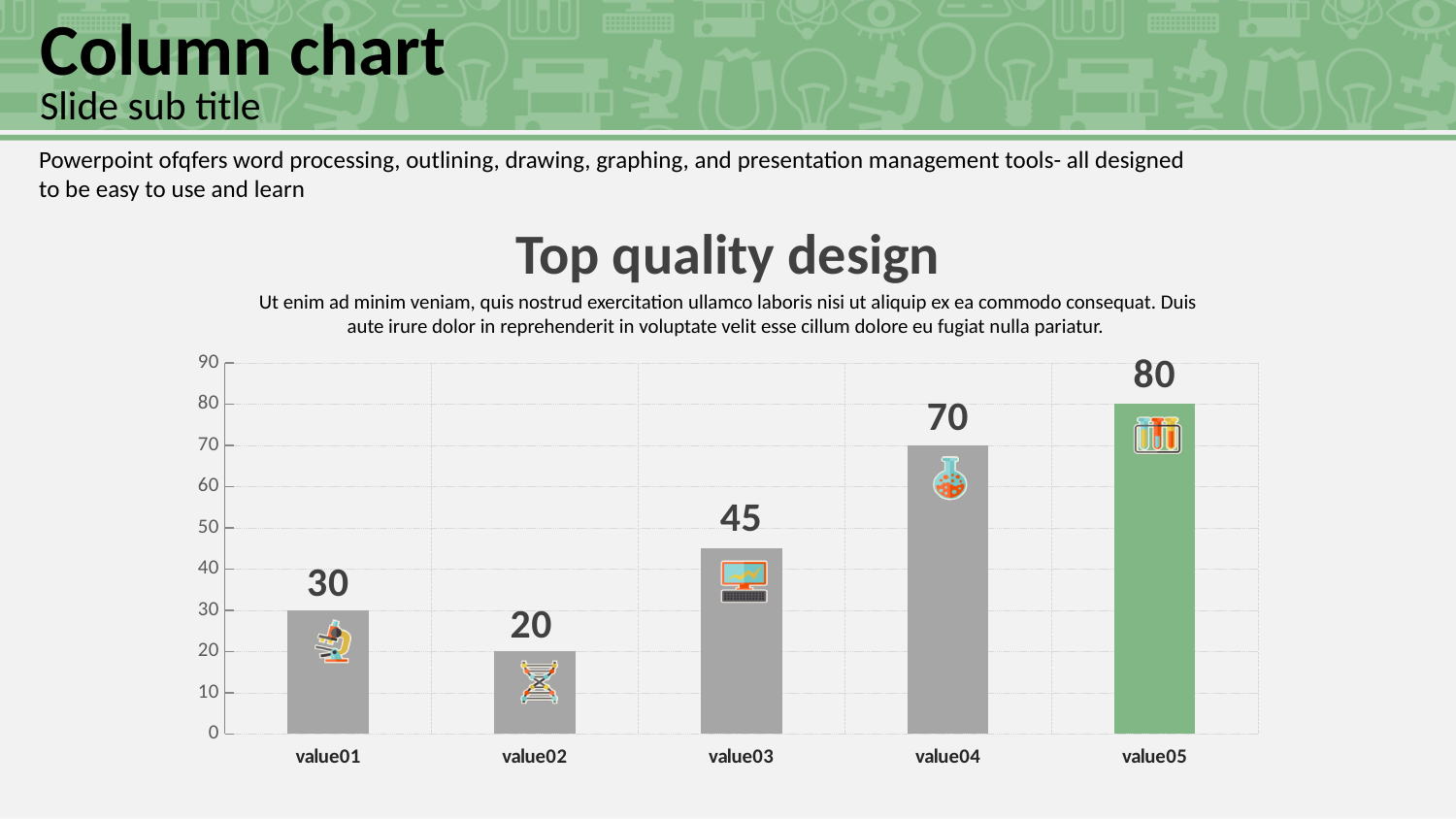
Which category has the lowest value? value02 How many categories are shown on the x axis? 5 What is the value for value01? 30 What is the value for value03? 45 Which bar is coloured green rather than grey? value05 Which is larger, the value for value01 or the value for value04? value04 What is the value for value05? 80 What is the difference between the values for value03 and value02? 25 Which category has the highest value? value05 Is the value for value04 greater or less than 60? greater What is the difference between the values for value05 and value04? 10 What kind of chart is shown on the slide? bar chart